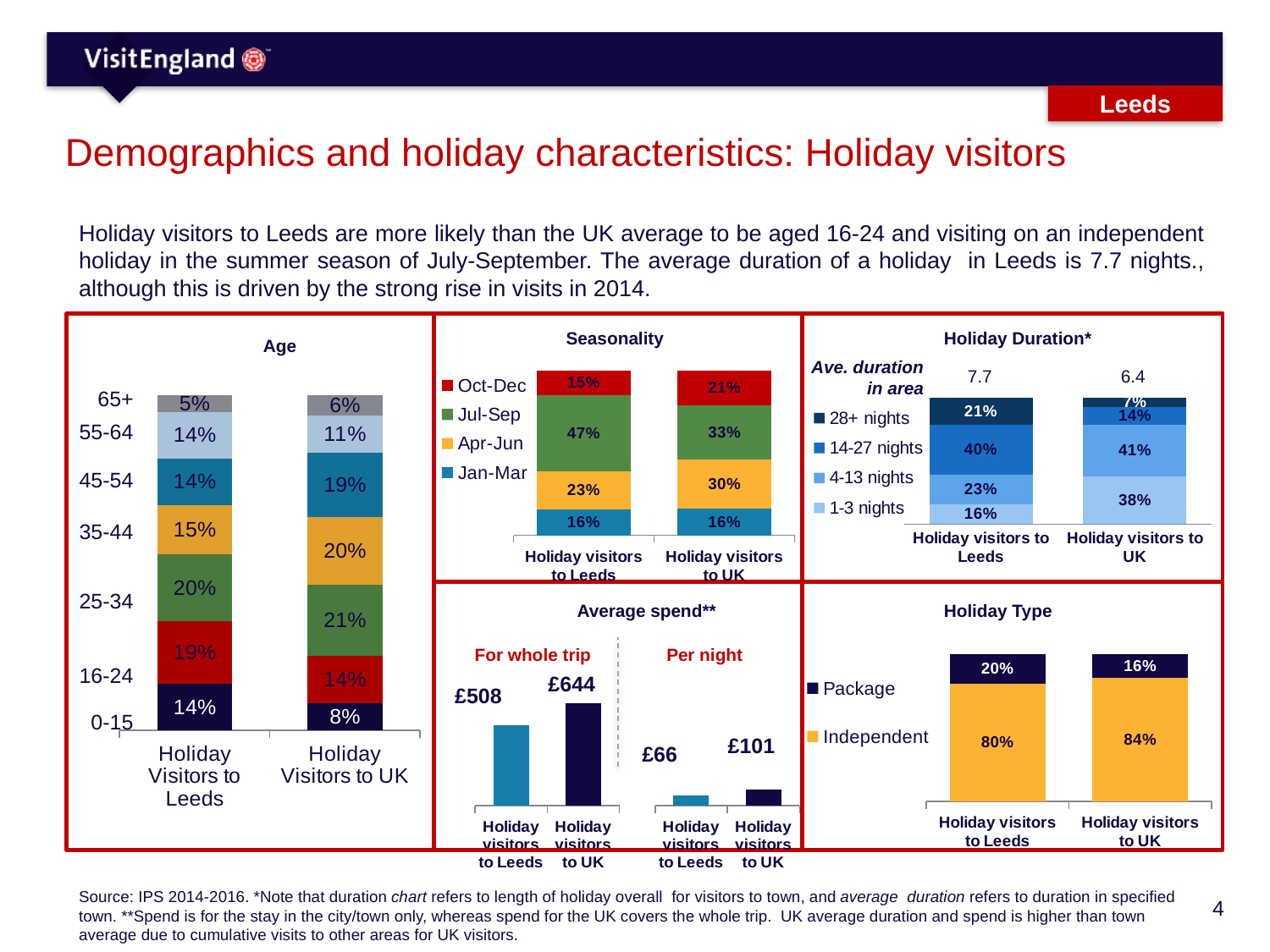
In the Seasonality chart, which season has the largest share for holiday visitors to the UK? Jul-Sep In the Holiday Duration chart, what is the average duration in area for holiday visitors to Leeds? 7.7 In the Age chart, what percentage of holiday visitors to the UK are aged 0-15? 8% In the Average spend chart, what is the spend for the whole trip for holiday visitors to Leeds? £508 In the Seasonality chart, what is the difference between the Jul-Sep share for holiday visitors to Leeds and for holiday visitors to the UK? 14% In the Holiday Duration chart, how many duration categories does the legend list? 4 What kind of chart is the Holiday Type chart? Stacked bar chart In the Age chart, what percentage of holiday visitors to Leeds are aged 16-24? 19% In the Average spend chart, what is the difference in per night spend between holiday visitors to the UK and holiday visitors to Leeds? £35 In the Seasonality chart, what share of holiday visitors to Leeds visit in Jul-Sep? 47% In the Holiday Type chart, what percentage of holiday visitors to Leeds are on a package holiday? 20% In the Holiday Duration chart, what percentage of holiday visitors to the UK stay 1-3 nights? 38%